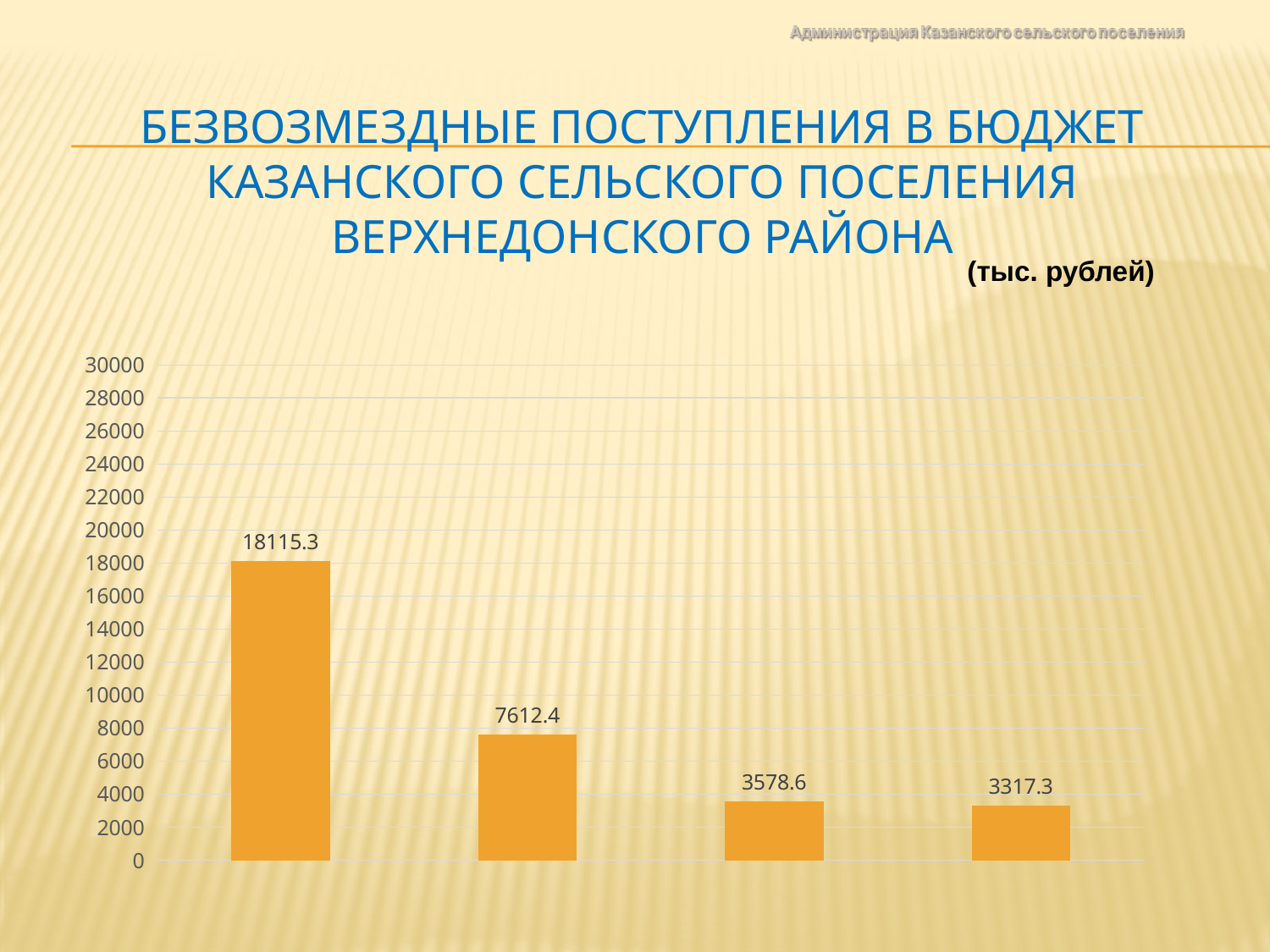
What is the value of the second bar from the left? 7612.4 What is the value of the last (rightmost) bar? 3317.3 What is the value of the first (leftmost) bar? 18115.3 Do the values rise or fall from left to right across the bars? Fall Which bar has the highest value? The first (leftmost) bar, 18115.3 What is the difference between the first bar and the second bar? 10502.9 What is the difference between the third bar and the fourth bar? 261.3 Which bar has the lowest value? The last (rightmost) bar, 3317.3 What is the value of the third bar from the left? 3578.6 How many bars are shown in the chart? 4 What kind of chart is shown on the slide? Bar chart Which is larger, the third bar or the fourth bar? The third bar (3578.6)